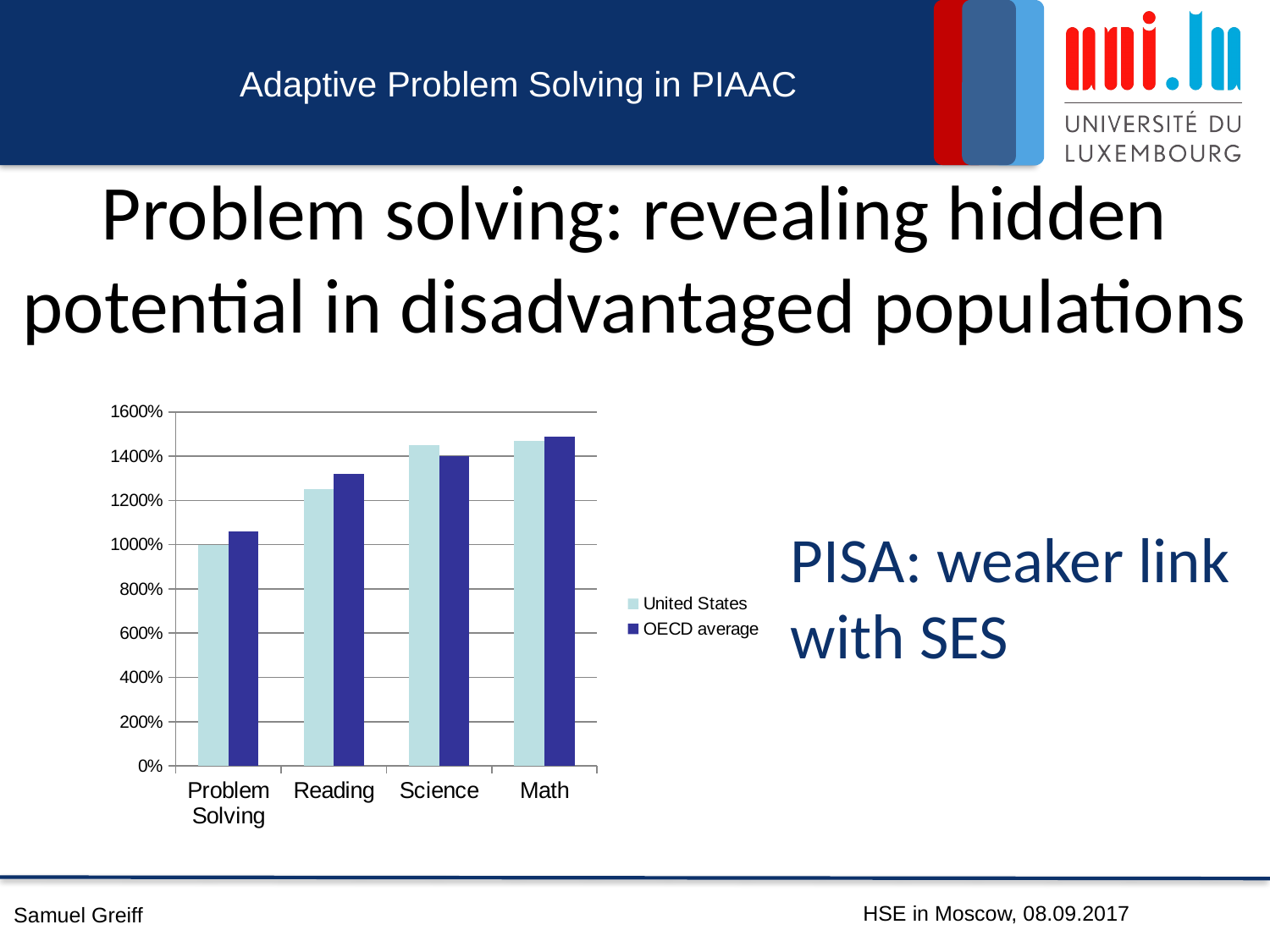
Which series is shown in dark blue in the chart's legend? OECD average For Science, which series has the larger value, United States or OECD average? United States How many categories are shown on the x axis of the chart? 4 For Problem Solving, which series has the larger value, United States or OECD average? OECD average What kind of chart is shown on the slide? bar chart Is the OECD average value for Math greater or less than 1400%? greater Which category has the highest value for the OECD average series? Math Is the United States value for Reading greater or less than 1200%? greater How many series does the chart's legend list? 2 Do the United States values rise or fall moving from Problem Solving to Math along the x axis? rise Which category has the lowest value for the OECD average series? Problem Solving Which category has the lowest value for the United States series? Problem Solving